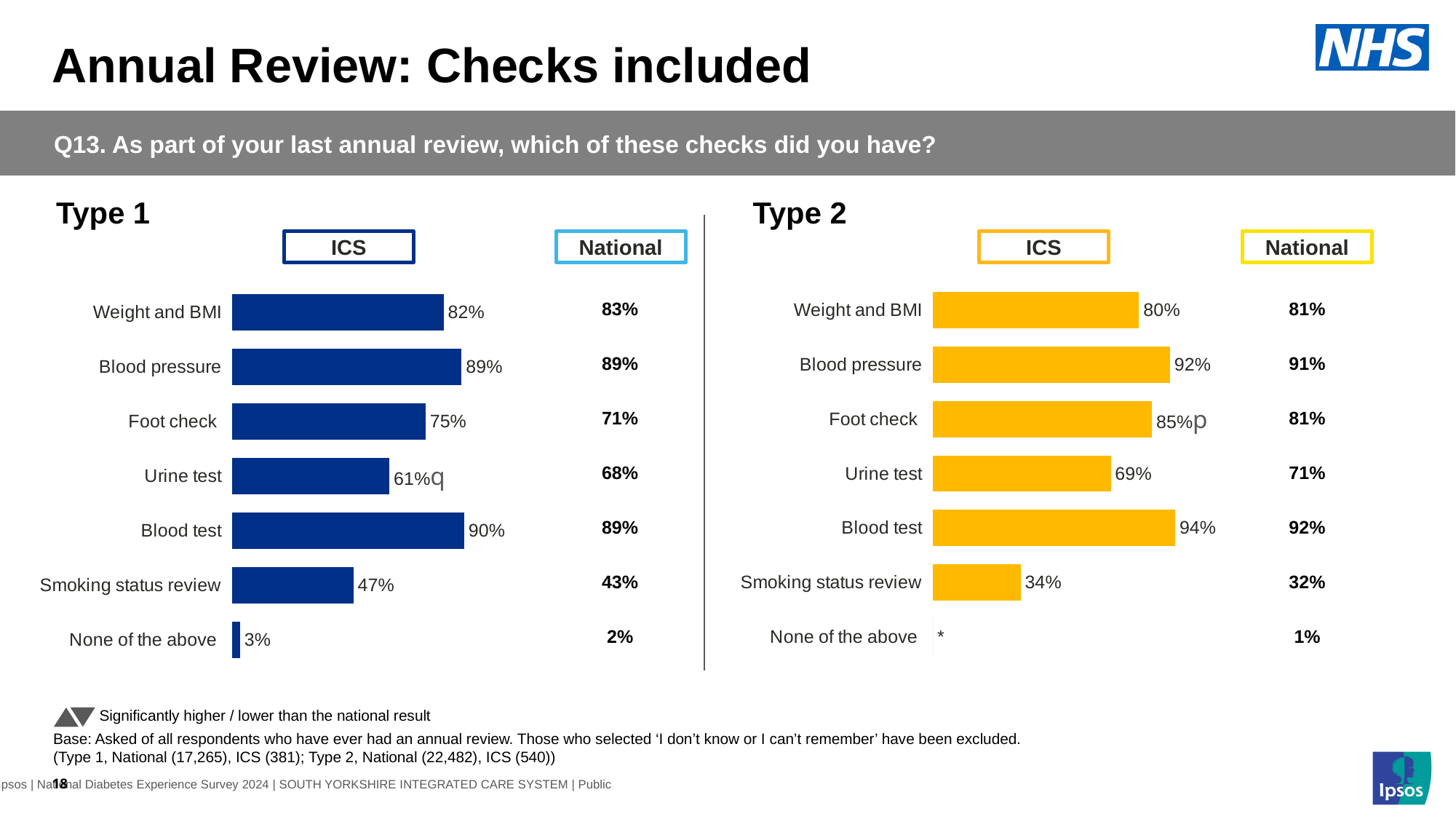
What colour are the bars in the Type 2 chart? yellow In the Type 2 chart, what is the difference between the ICS values for Blood pressure and Weight and BMI? 12 percentage points In the Type 1 chart, what is the National value for Smoking status review? 43% In the Type 1 chart, what is the ICS value for Foot check? 75% In the Type 1 chart, what is the difference between the ICS and National values for Urine test? 7 percentage points In the Type 2 chart, what is the ICS value for Blood test? 94% In the Type 2 chart, what is the National value for Urine test? 71% In the Type 1 chart, which check has the highest ICS value? Blood test In the Type 2 chart, which check has the lowest ICS value among those with a printed percentage? Smoking status review What kind of chart is used for the Type 1 ICS results? bar chart In the Type 2 chart, is the ICS value for Foot check larger or smaller than the National value? larger How many checks are listed in the Type 1 chart? 7